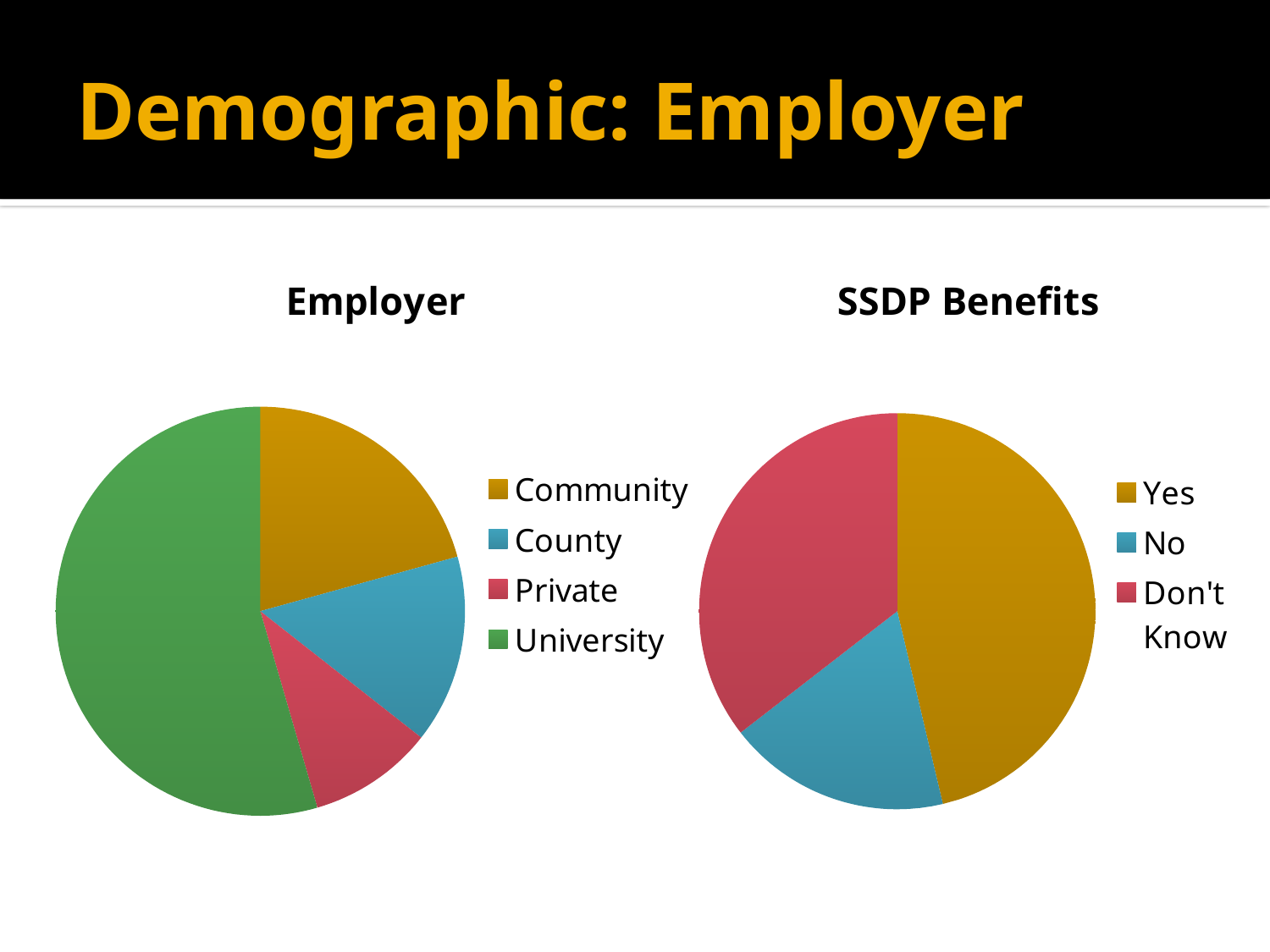
What is the title of the pie chart on the right side of the slide? SSDP Benefits In the SSDP Benefits pie chart, which category has the smallest slice? No In the Employer pie chart, which category has the smallest slice? Private How many categories does the SSDP Benefits pie chart show? 3 How many categories does the Employer pie chart show? 4 In the Employer pie chart, what colour is the University slice? green In the SSDP Benefits pie chart, which slice is larger, No or Don't Know? Don't Know What kind of chart is the Employer chart? pie chart In the SSDP Benefits pie chart, which category has the largest slice? Yes In the Employer pie chart, which slice is larger, Community or County? Community What kind of chart is the SSDP Benefits chart? pie chart In the Employer pie chart, which category has the largest slice? University